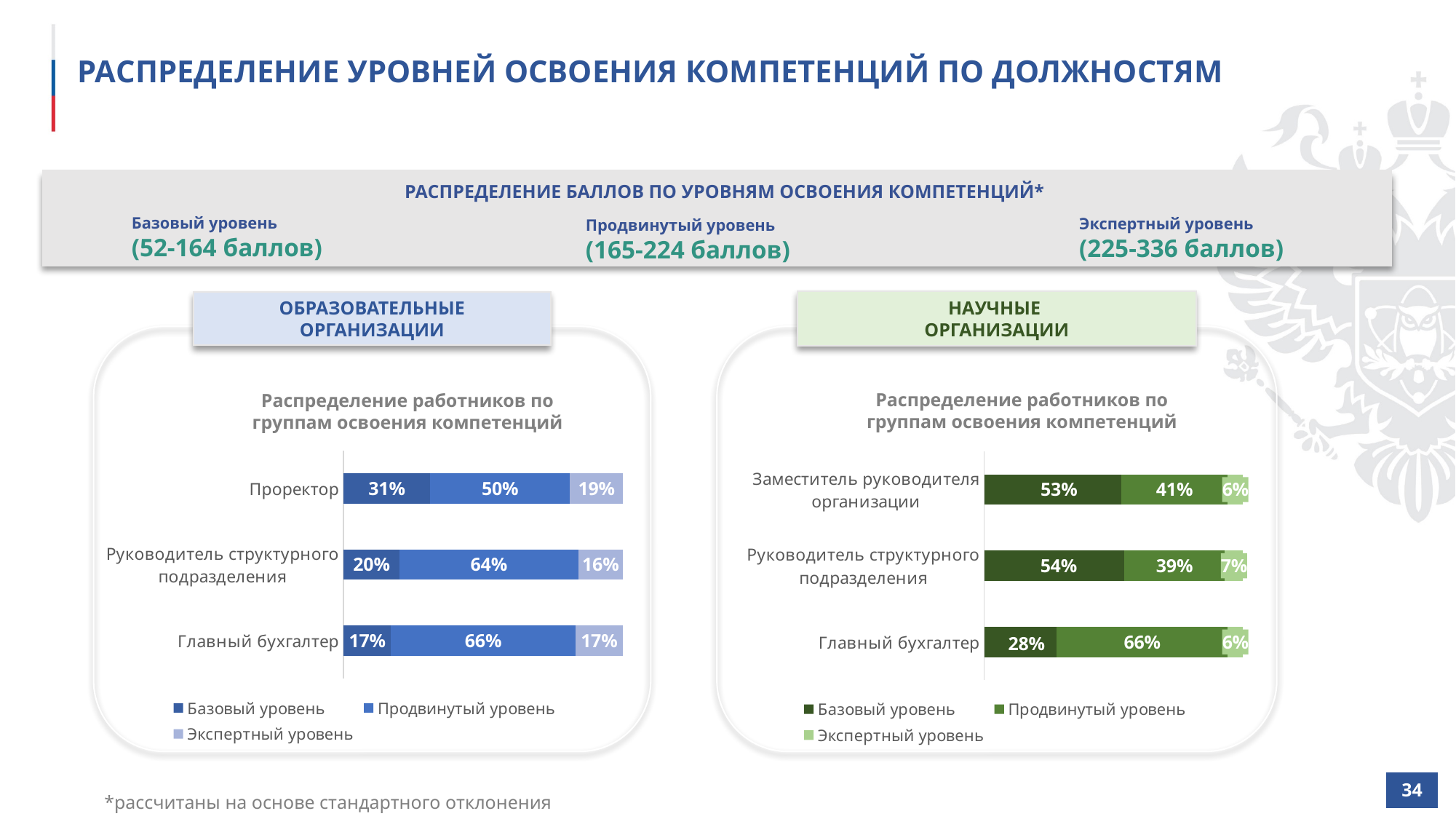
In the chart for Образовательные организации, what is the difference between Продвинутый уровень and Базовый уровень for Руководитель структурного подразделения? 44% How many series does the legend list in the chart for Образовательные организации? 3 In the chart for Научные организации, which is larger for Заместитель руководителя организации: Базовый уровень or Продвинутый уровень? Базовый уровень What type of chart is used for Образовательные организации? Stacked bar chart In the chart for Образовательные организации, what is the value of Продвинутый уровень for Проректор? 50% In the chart for Научные организации, what is the total of the stacked bar for Главный бухгалтер? 100% In the chart for Образовательные организации, what is the value of Базовый уровень for Главный бухгалтер? 17% How many categories are shown in the chart for Научные организации? 3 In the chart for Образовательные организации, which category has the highest value for Продвинутый уровень? Главный бухгалтер In the chart for Научные организации, what is the value of Экспертный уровень for Руководитель структурного подразделения? 7% In the chart for Научные организации, which category has the lowest value for Базовый уровень? Главный бухгалтер In the chart for Научные организации, what is the value of Базовый уровень for Заместитель руководителя организации? 53%